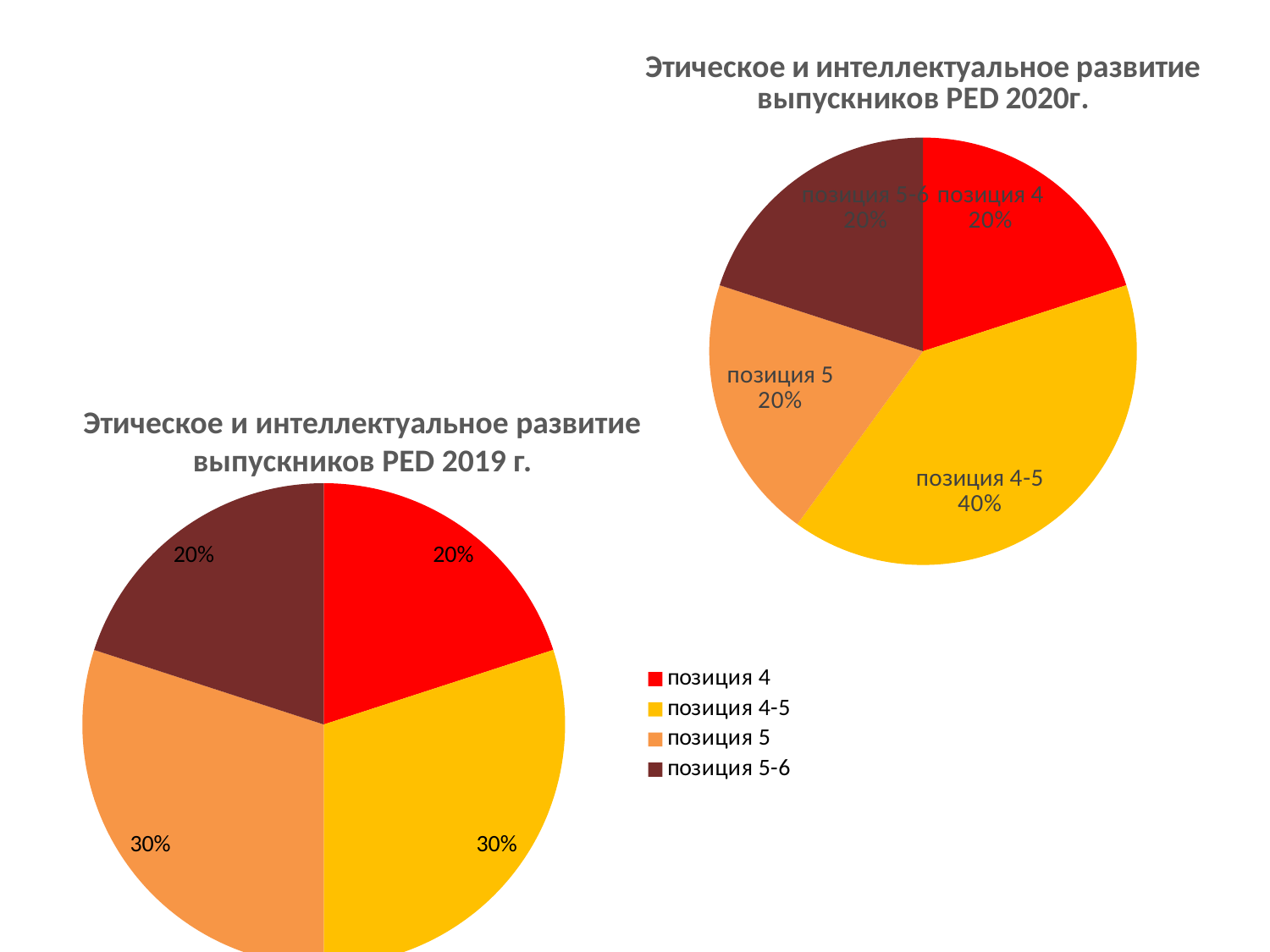
In the chart titled "Этическое и интеллектуальное развитие выпускников PED 2019 г.", what share does the dark red slice (позиция 5-6) have? 20% In the chart titled "Этическое и интеллектуальное развитие выпускников PED 2019 г.", what share does the red slice (позиция 4) have? 20% In the chart titled "Этическое и интеллектуальное развитие выпускников PED 2020г.", what is the difference between the shares of "позиция 4-5" and "позиция 4"? 20% In the chart titled "Этическое и интеллектуальное развитие выпускников PED 2020г.", which category has the largest slice? позиция 4-5 How many entries does the legend on the slide list? 4 What type of chart is used for "Этическое и интеллектуальное развитие выпускников PED 2019 г."? Pie chart Which colour represents "позиция 4-5" in the legend? Yellow In the chart titled "Этическое и интеллектуальное развитие выпускников PED 2019 г.", what share does the yellow slice (позиция 4-5) have? 30% In the chart titled "Этическое и интеллектуальное развитие выпускников PED 2020г.", what share does "позиция 4-5" have? 40% In the chart titled "Этическое и интеллектуальное развитие выпускников PED 2019 г.", which is larger: the orange slice (позиция 5) or the dark red slice (позиция 5-6)? позиция 5 In the chart titled "Этическое и интеллектуальное развитие выпускников PED 2020г.", what share does "позиция 5" have? 20% In the chart titled "Этическое и интеллектуальное развитие выпускников PED 2020г.", how many slices does the pie have? 4